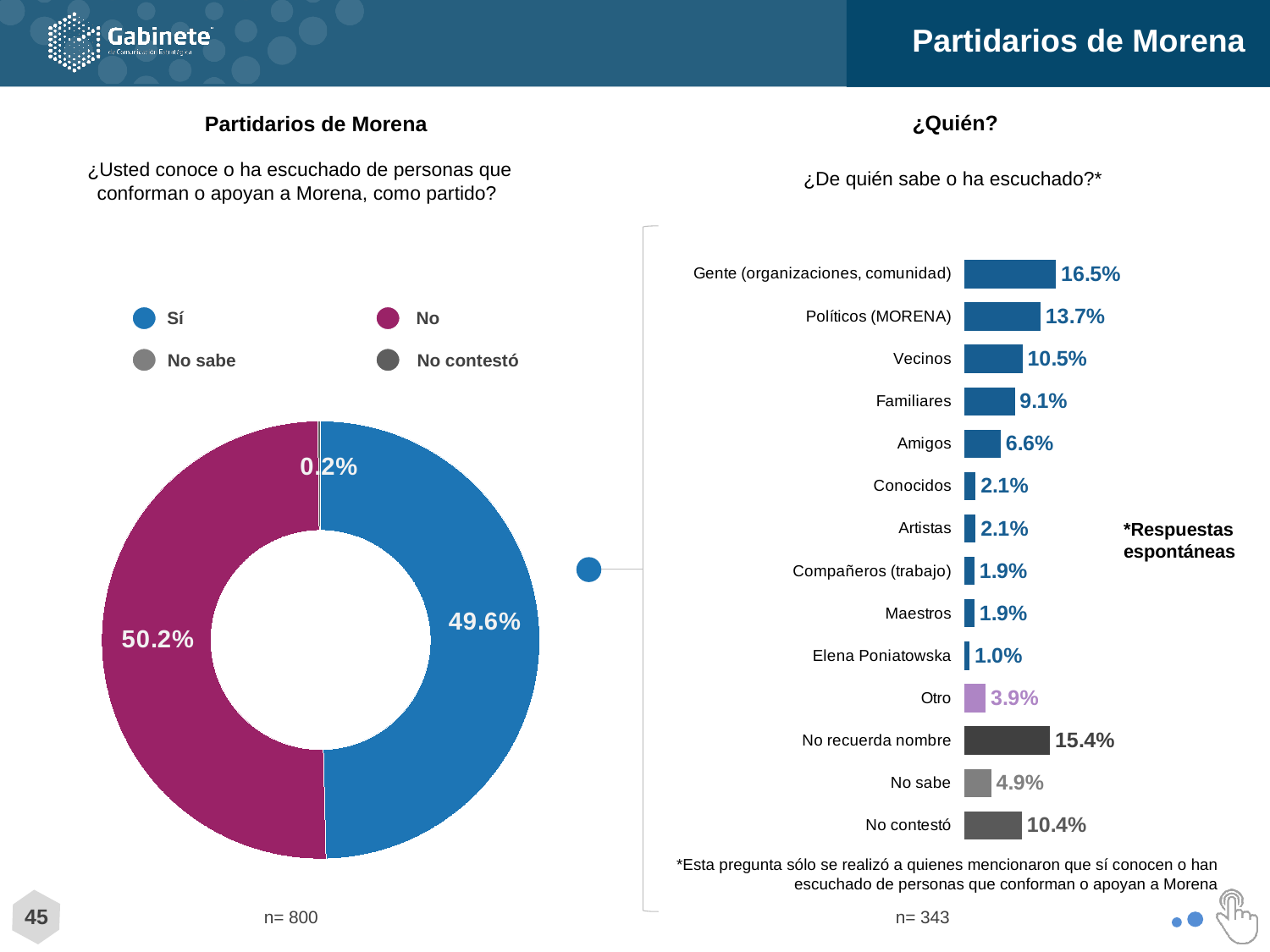
In the "¿Quién?" bar chart, which category has the lowest value? Elena Poniatowska In the "¿Quién?" bar chart, what is the value for "Políticos (MORENA)"? 13.7% In the donut chart on the left, what is the difference between the "No" share and the "Sí" share? 0.6% How many categories are shown in the "¿Quién?" bar chart? 14 In the donut chart on the left, what percentage answered "Sí"? 49.6% In the "¿Quién?" bar chart, what is the difference between "Vecinos" and "Familiares"? 1.4% In the "¿Quién?" bar chart, which category has the highest value? Gente (organizaciones, comunidad) In the "¿Quién?" bar chart, what is the value for "No recuerda nombre"? 15.4% In the donut chart on the left, which is larger, the share for "Sí" or the share for "No"? No How many entries does the legend of the donut chart on the left list? 4 In the donut chart on the left, what percentage answered "No"? 50.2% What type of chart is the "¿Quién?" chart on the right? Bar chart